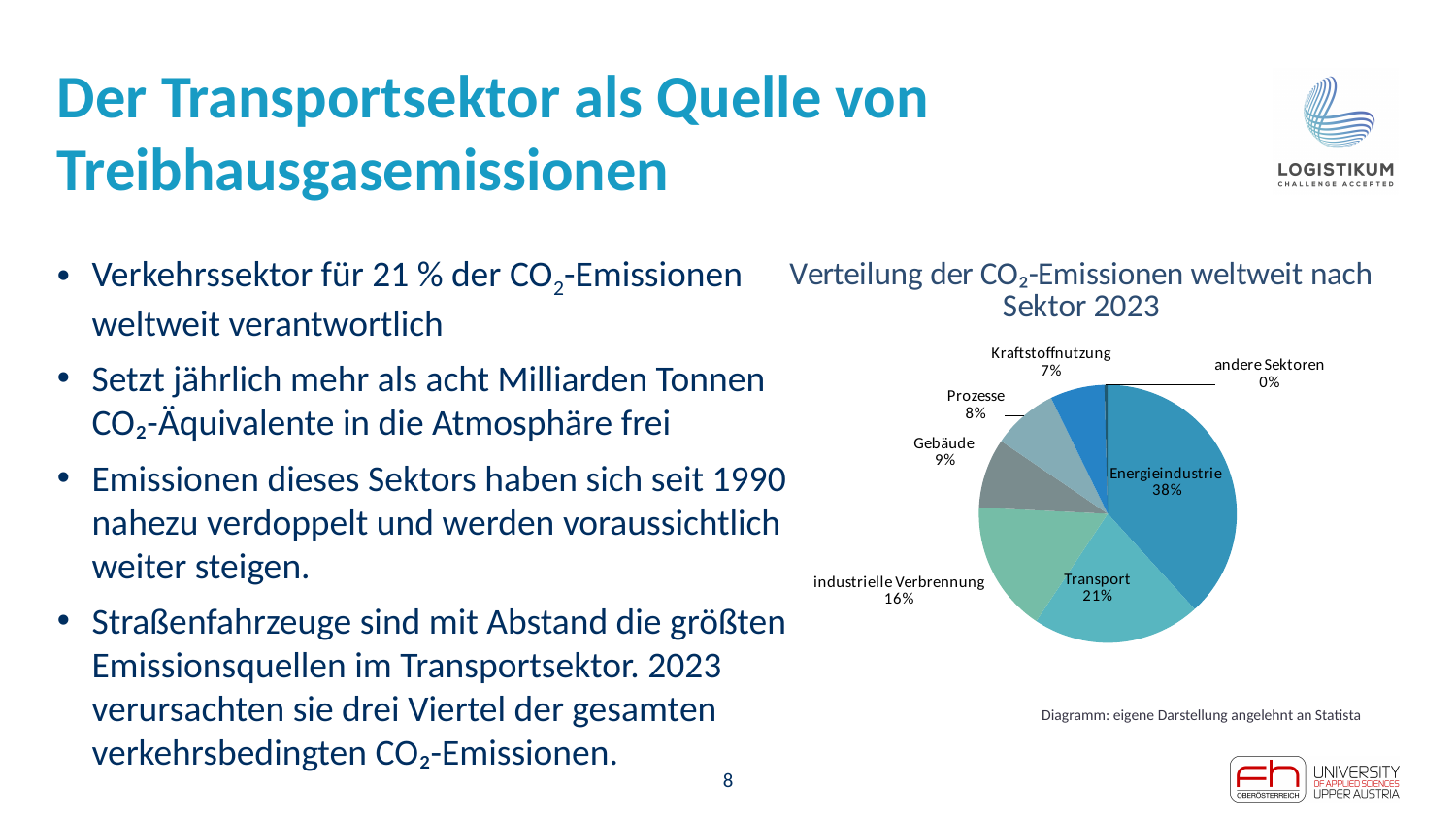
What share of the pie does Transport have? 21% What is the value for Gebäude? 9% What is the value for Kraftstoffnutzung? 7% What is the difference between the shares of Energieindustrie and Transport? 17% What is the value for industrielle Verbrennung? 16% What is the title of the chart? Verteilung der CO₂-Emissionen weltweit nach Sektor 2023 Which sector has the largest slice of the pie? Energieindustrie What kind of chart is shown on the slide? pie chart How many sectors are shown in the pie chart? 7 Which is larger, the share for Prozesse or the share for Gebäude? Gebäude Which sector has the smallest slice of the pie? andere Sektoren What share of the pie does Energieindustrie have? 38%